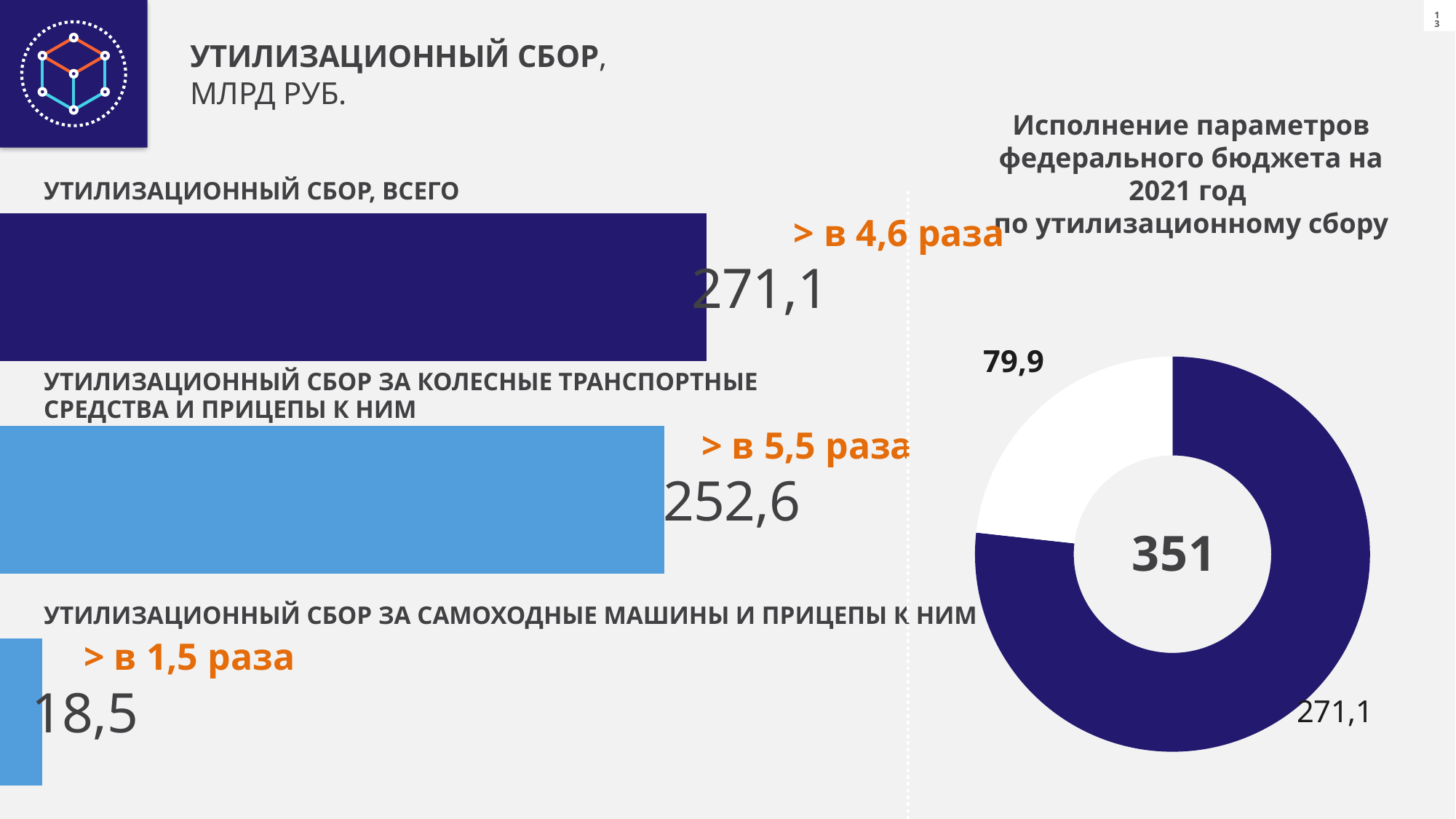
In the bar chart on the left, what is the value for 'Утилизационный сбор, всего'? 271,1 What kind of chart is shown on the left side of the slide? Bar chart In the chart 'Исполнение параметров федерального бюджета на 2021 год по утилизационному сбору', which segment is larger, the one labelled 271,1 or the one labelled 79,9? 271,1 In the bar chart on the left, what orange annotation is shown next to the bar for 'Утилизационный сбор, всего'? > в 4,6 раза In the bar chart on the left, what is the value for 'Утилизационный сбор за самоходные машины и прицепы к ним'? 18,5 In the bar chart on the left, what is the value for 'Утилизационный сбор за колесные транспортные средства и прицепы к ним'? 252,6 In the bar chart on the left, which category has the lowest value? Утилизационный сбор за самоходные машины и прицепы к ним In the bar chart on the left, which category has the highest value? Утилизационный сбор, всего In the bar chart on the left, how many categories are shown? 3 In the bar chart on the left, what is the difference between the value for 'Утилизационный сбор, всего' and the value for 'Утилизационный сбор за колесные транспортные средства и прицепы к ним'? 18,5 In the chart 'Исполнение параметров федерального бюджета на 2021 год по утилизационному сбору', what total is shown in the centre? 351 In the chart 'Исполнение параметров федерального бюджета на 2021 год по утилизационному сбору', what is the value of the smaller (white) segment? 79,9